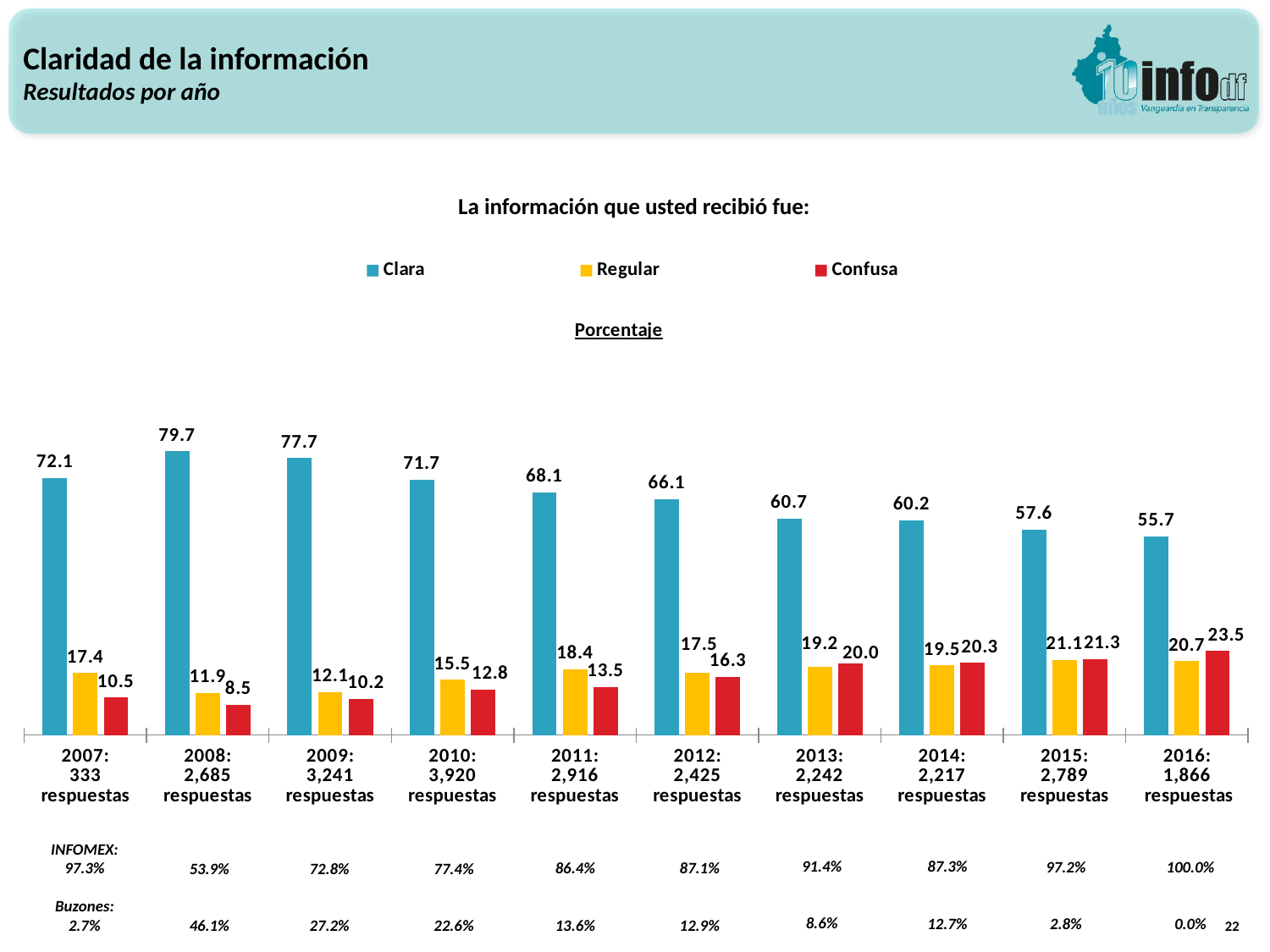
Which is larger in 2014, Regular or Confusa? Confusa What colour are the Regular bars? yellow What is the value for Confusa in 2016? 23.5 In which year is the Clara value highest? 2008 What kind of chart is shown? bar chart What is the value for Clara in 2007? 72.1 How many years are shown on the x axis? 10 Does the Clara value rise or fall from 2008 to 2016? fall What is the difference between the Clara values for 2008 and 2016? 24.0 In which year is the Confusa value lowest? 2008 How many series does the legend list? 3 What is the value for Regular in 2011? 18.4